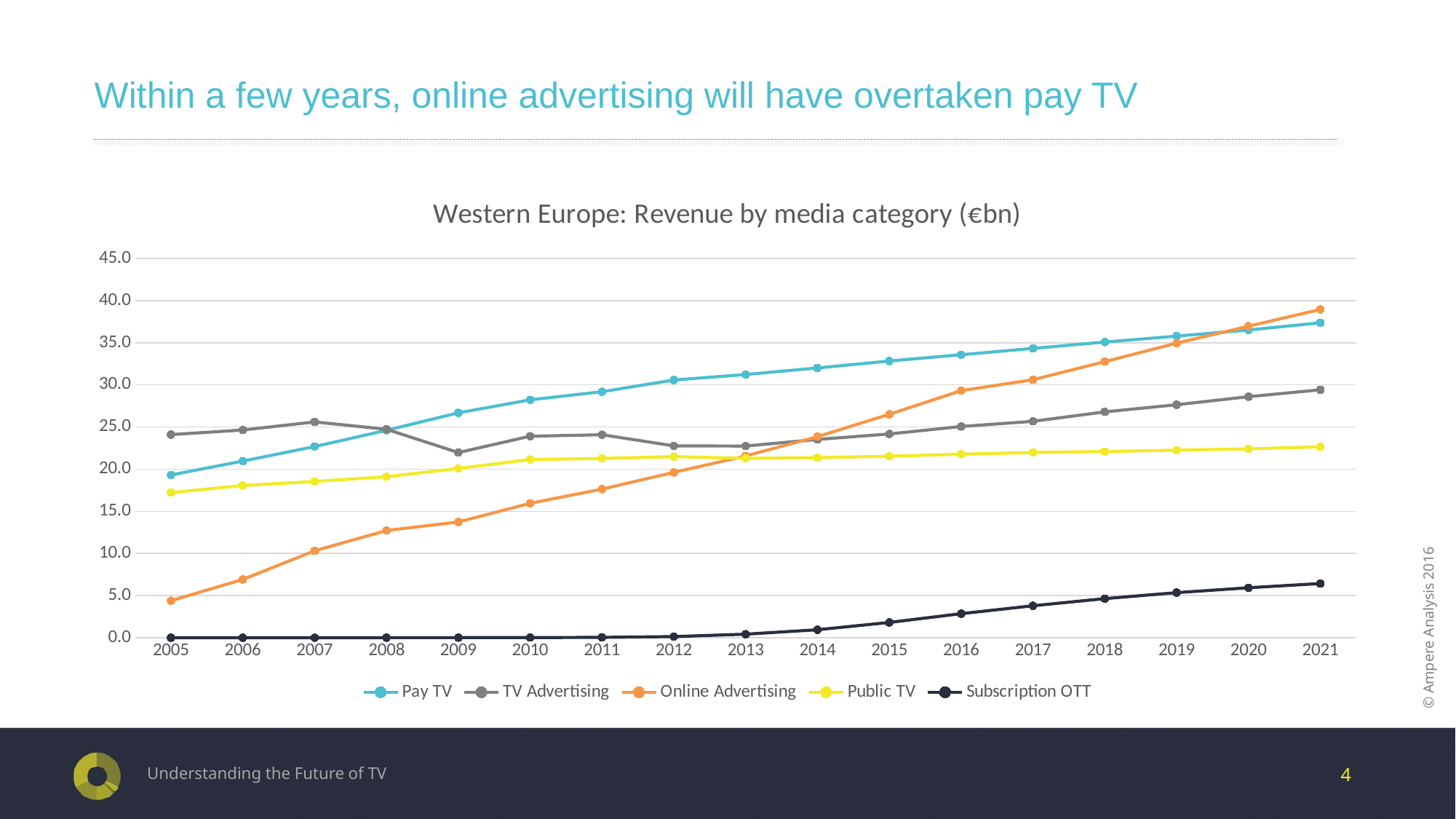
How many series does the legend list? 5 Does the Online Advertising line rise or fall from 2005 to 2021? Rises Which series has the highest value in 2021? Online Advertising How many years are plotted along the x axis? 17 In 2015, which is larger: Pay TV or Online Advertising? Pay TV What is the title of the chart? Western Europe: Revenue by media category (€bn) Which series has the lowest value in 2005? Subscription OTT What kind of chart is shown on the slide? Line chart Is the value for TV Advertising in 2009 greater or less than 25.0? less Is the value for Pay TV in 2021 greater or less than 35.0? greater In 2005, which is larger: TV Advertising or Public TV? TV Advertising Is the value for Subscription OTT in 2021 greater or less than 5.0? greater